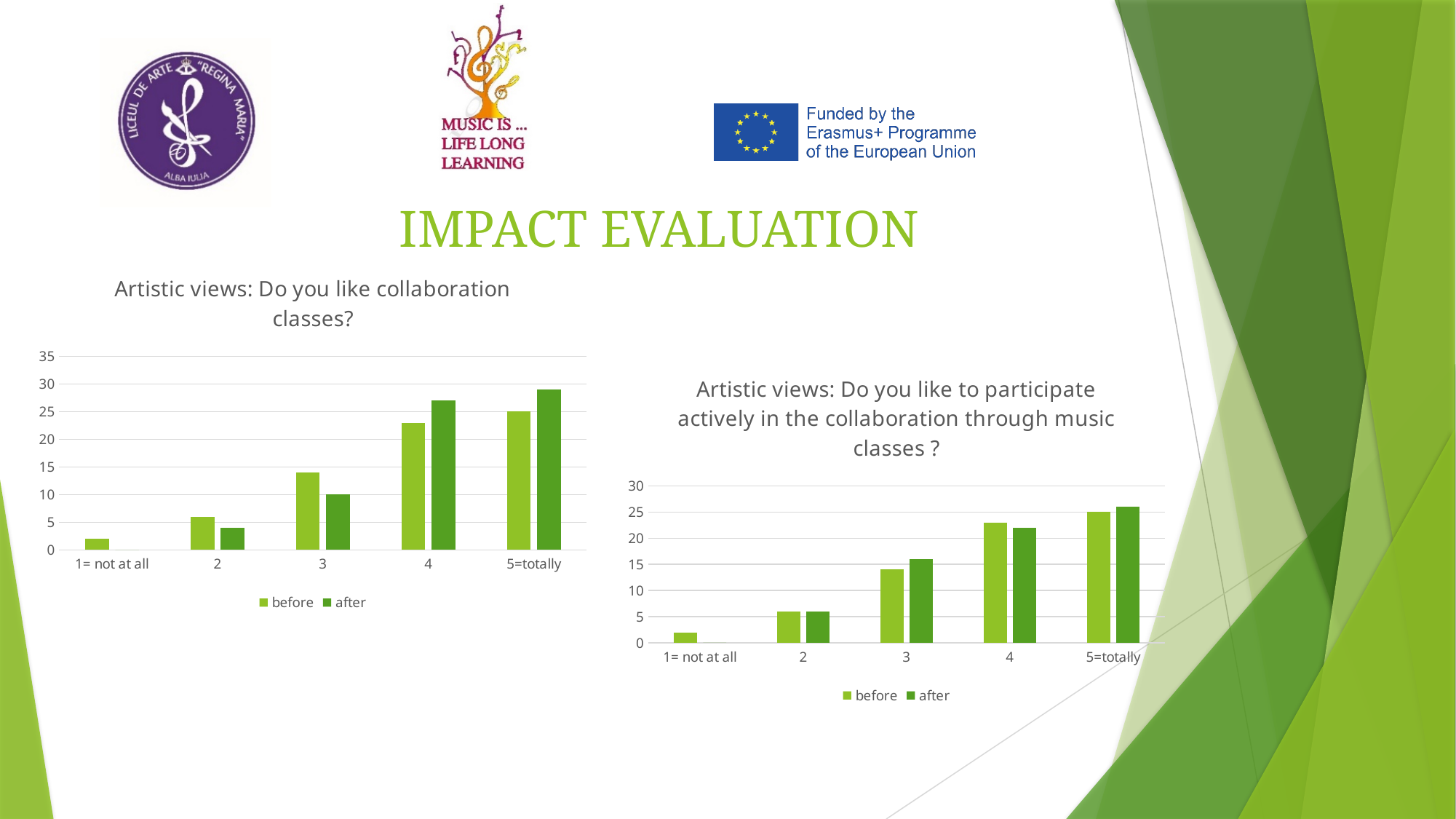
In the 'Do you like to participate actively in the collaboration through music classes?' chart, which category has the highest 'before' bar? 5=totally In the 'Do you like collaboration classes?' chart, which category has the lowest 'before' bar? 1= not at all In the 'Do you like collaboration classes?' chart, do the 'before' values rise or fall from '1= not at all' to '5=totally'? rise In the 'Do you like collaboration classes?' chart, is the 'before' value for category 4 greater or less than 20? greater In the 'Do you like to participate actively in the collaboration through music classes?' chart, is the 'after' value for category 2 greater or less than 10? less In the 'Do you like collaboration classes?' chart, how many series does the legend list? 2 In the 'Do you like collaboration classes?' chart, what is the 'before' value for '5=totally'? 25 In the 'Do you like collaboration classes?' chart, which category has the highest 'after' bar? 5=totally In the 'Do you like collaboration classes?' chart, for category 3, which is larger: 'before' or 'after'? before What kind of chart is the 'Artistic views: Do you like collaboration classes?' chart? bar chart In the 'Do you like collaboration classes?' chart, for category 4, which is larger: 'before' or 'after'? after In the 'Do you like to participate actively in the collaboration through music classes?' chart, how many categories are shown on the x axis? 5